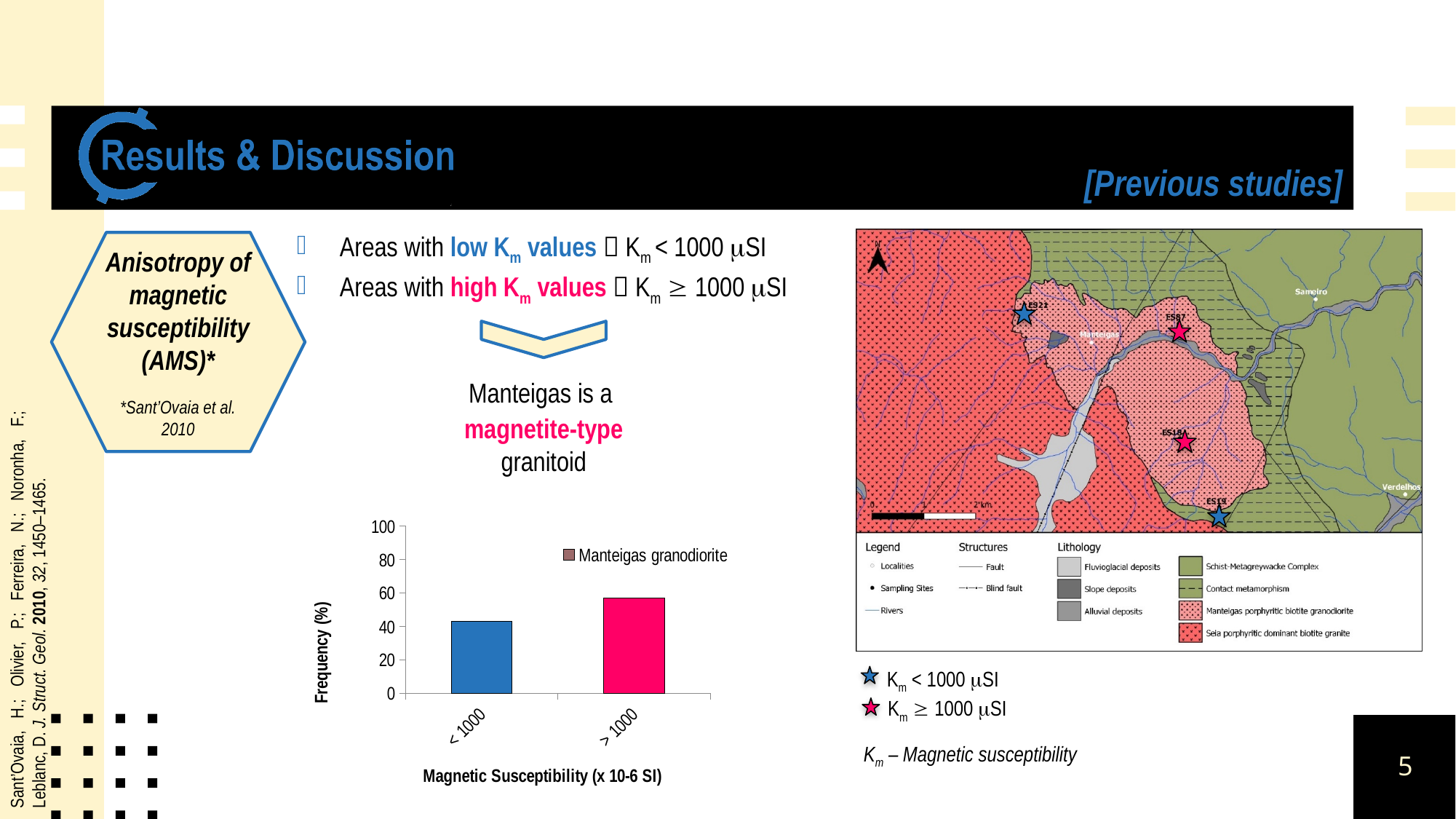
Which category has the lowest frequency in the bar chart? < 1000 Is the frequency for "> 1000" greater or less than 80? less Which category has the highest frequency in the bar chart? > 1000 What kind of chart is shown on the slide? bar chart Is the frequency for "> 1000" greater or less than 40? greater Is the frequency for "< 1000" greater or less than 60? less How many series does the legend of the bar chart list? 1 Is the frequency for "< 1000" or for "> 1000" larger? > 1000 How many categories are shown on the x axis of the bar chart? 2 What series name is shown in the legend of the bar chart? Manteigas granodiorite What is the title of the y axis of the bar chart? Frequency (%)